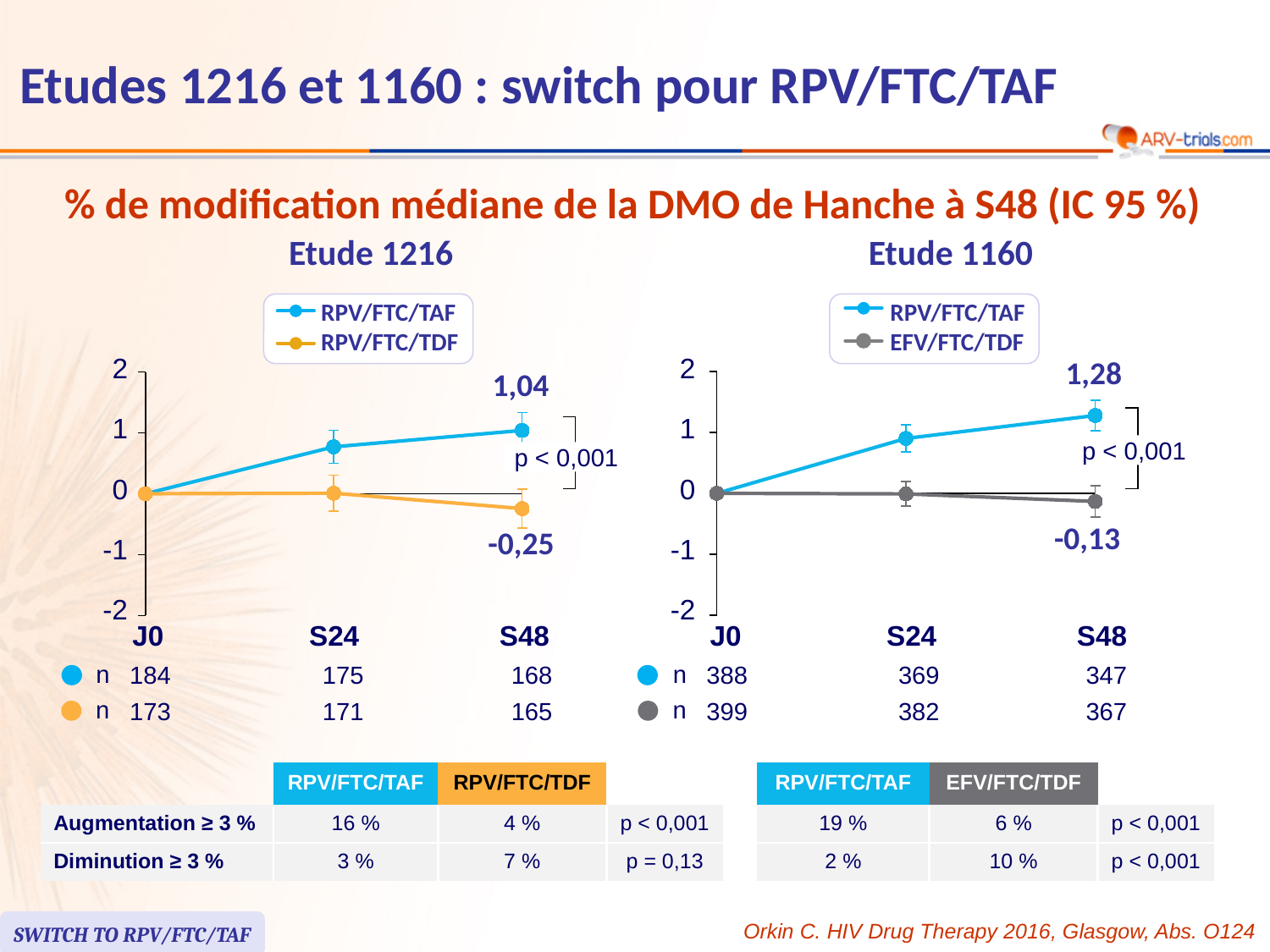
In the Etude 1160 chart, which series has the higher value at S48, RPV/FTC/TAF or EFV/FTC/TDF? RPV/FTC/TAF How many series does the legend of the Etude 1216 chart list? 2 What kind of chart is the Etude 1160 chart? Line chart In the Etude 1216 chart, what is the value for RPV/FTC/TDF at S48? -0,25 In the Etude 1216 chart, is the value for RPV/FTC/TAF at S24 greater or less than 0? greater In the Etude 1160 chart, what is the value for RPV/FTC/TAF at S48? 1,28 In the Etude 1216 chart, what is the value for RPV/FTC/TAF at S48? 1,04 How many time points are shown on the x axis of the Etude 1160 chart? 3 In the Etude 1160 chart, what is the value for EFV/FTC/TDF at S48? -0,13 In the Etude 1160 chart, what is the difference between the RPV/FTC/TAF and EFV/FTC/TDF values at S48? 1,41 In the Etude 1216 chart, what is the difference between the RPV/FTC/TAF and RPV/FTC/TDF values at S48? 1,29 In the Etude 1160 chart, does the RPV/FTC/TAF series rise or fall from J0 to S48? Rise